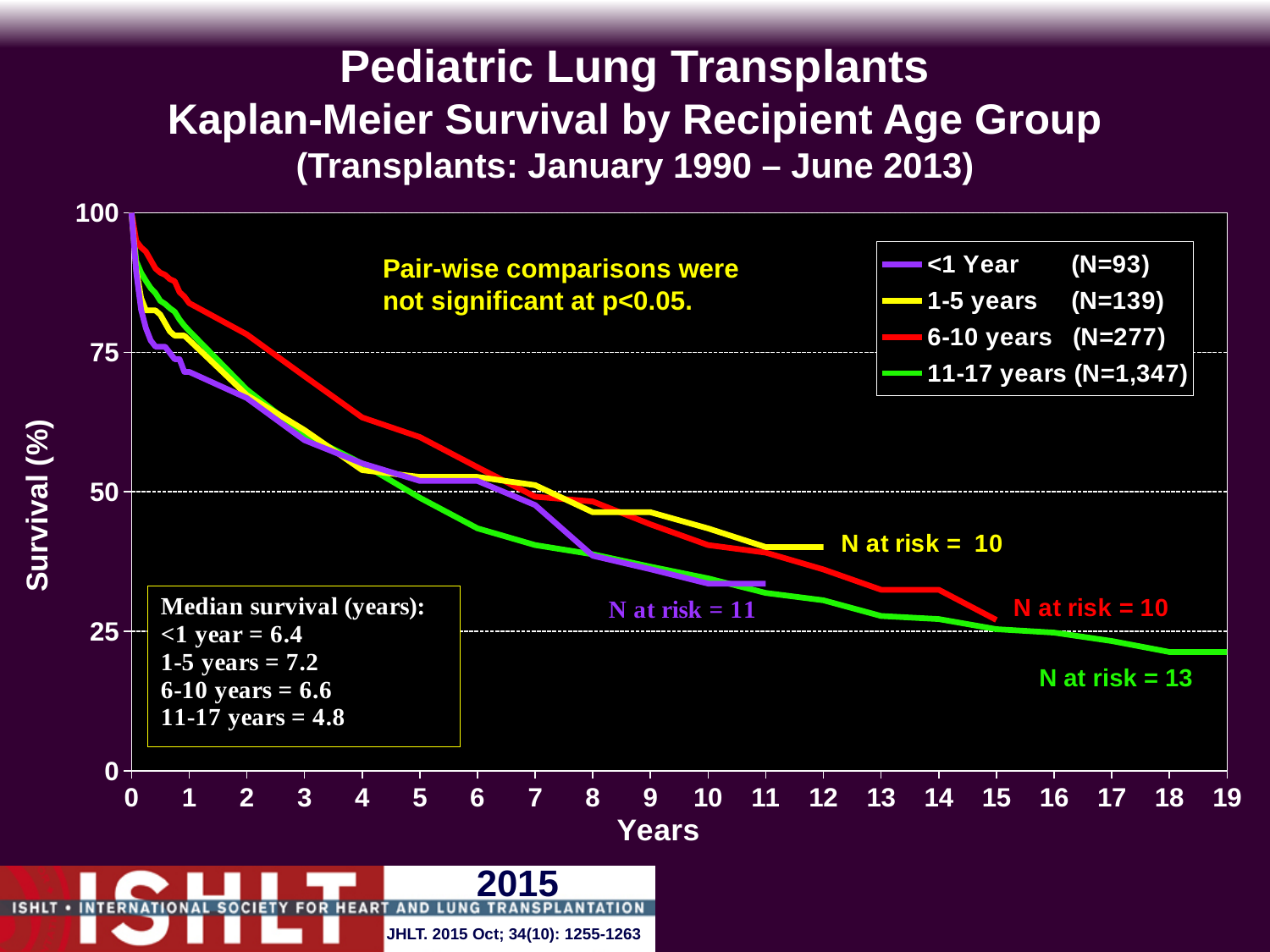
According to the legend, what is N for the 6-10 years group? 277 What is the N at risk shown for the 11-17 years group? 13 Do the survival curves rise or fall as years increase? Fall What kind of chart is shown on the slide? Line chart Which recipient age group has the highest median survival? 1-5 years Is the survival value for the 6-10 years group at 5 years greater or less than 50? greater What is the median survival in years for the 1-5 years group? 7.2 What is the difference in median survival (years) between the 1-5 years group and the 11-17 years group? 2.4 Is the survival value for the 11-17 years group at 19 years greater or less than 25? less How many series does the legend list? 4 Which group has a larger N, <1 Year or 1-5 years? 1-5 years Which recipient age group has the lowest median survival? 11-17 years